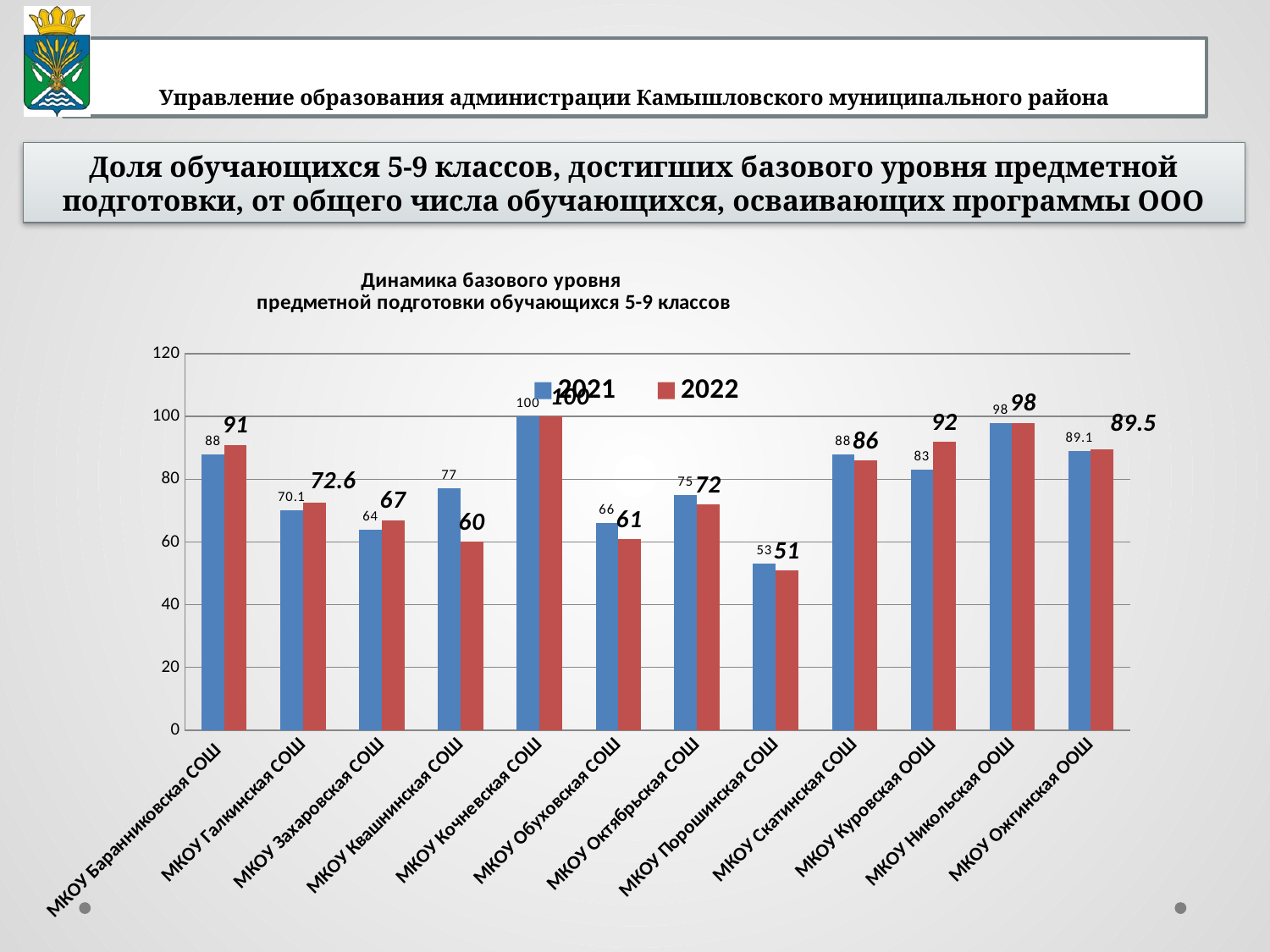
Which school has the lowest 2022 value? МКОУ Порошинская СОШ How many series does the legend list? 2 Which colour represents the 2022 series in the chart? Red What is the 2021 value for МКОУ Квашнинская СОШ? 77 What is the difference between the 2022 and 2021 values for МКОУ Куровская ООШ? 9 How many schools are shown on the x axis? 12 What kind of chart is shown on the slide? Bar chart What is the 2022 value for МКОУ Галкинская СОШ? 72.6 For МКОУ Обуховская СОШ, which year has the larger value, 2021 or 2022? 2021 What is the 2022 value for МКОУ Ожгинская ООШ? 89.5 Which school has the highest 2021 value? МКОУ Кочневская СОШ What is the difference between the 2021 and 2022 values for МКОУ Квашнинская СОШ? 17